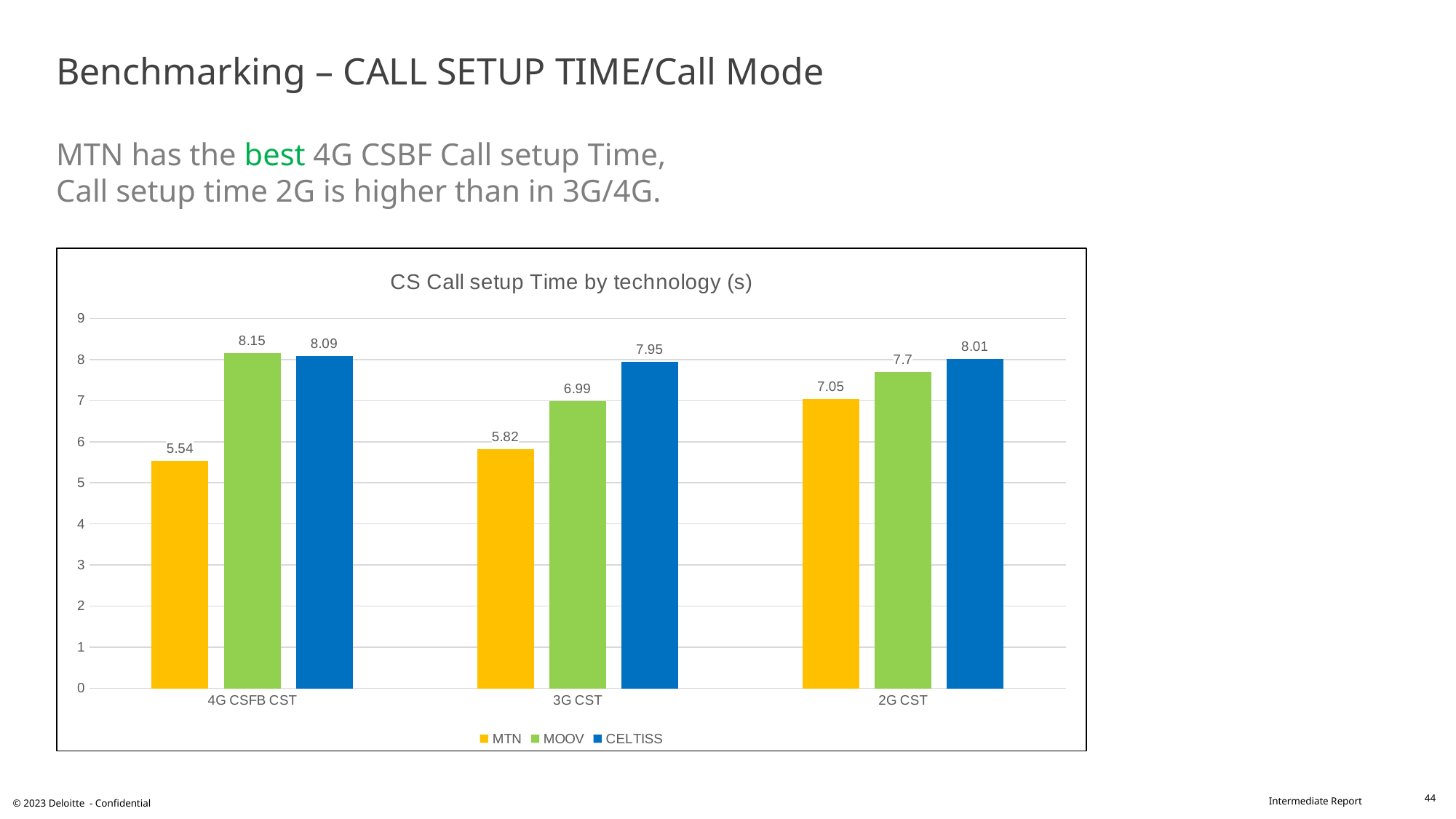
What is the CELTISS value for 3G CST? 7.95 Is the MOOV value for 3G CST greater or less than 8? less Which is larger for 2G CST, the MTN value or the CELTISS value? CELTISS What is the title of the chart? CS Call setup Time by technology (s) What is the MTN value for 4G CSFB CST? 5.54 What kind of chart is shown on the slide? bar chart What is the difference between the MOOV and MTN values for 4G CSFB CST? 2.61 Which operator has the highest call setup time for 4G CSFB CST? MOOV How many technology categories are shown on the x axis? 3 What is the MOOV value for 2G CST? 7.7 How many series does the legend list? 3 Which operator has the lowest call setup time for 3G CST? MTN